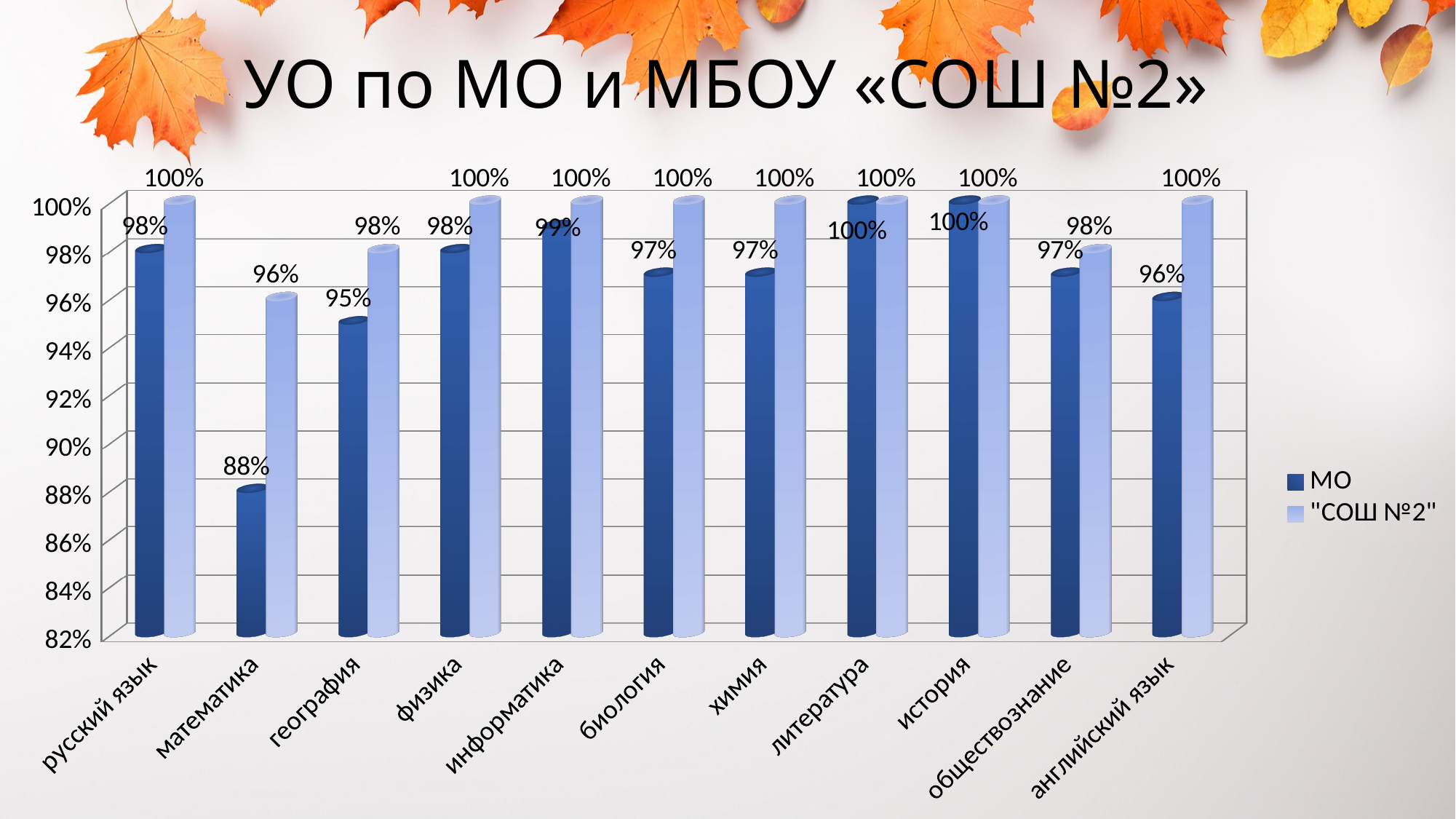
Which category has the lowest МО value? математика What is the difference between the "СОШ №2" and МО values for математика? 8% What is the "СОШ №2" value for география? 98% How many categories are shown on the x axis? 11 What is the title of the chart? УО по МО и МБОУ «СОШ №2» What kind of chart is shown on the slide? bar chart What is the МО value for информатика? 99% What is the "СОШ №2" value for математика? 96% Which is larger for английский язык: the МО value or the "СОШ №2" value? "СОШ №2" Which category has the lowest "СОШ №2" value? математика What is the МО value for математика? 88% How many series does the legend list? 2